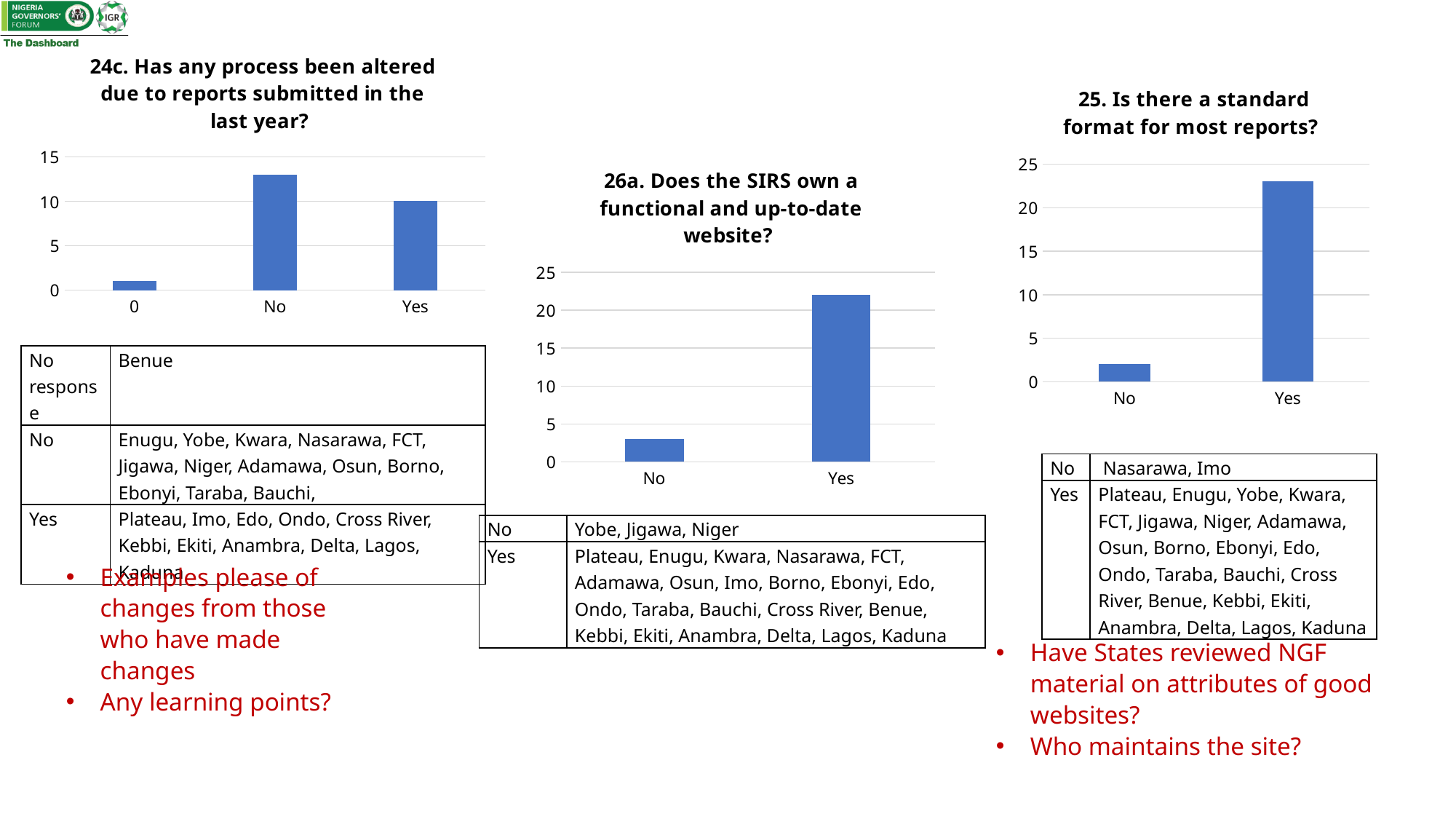
In the chart "24c. Has any process been altered due to reports submitted in the last year?", how many categories are shown on the x axis? 3 In the chart "26a. Does the SIRS own a functional and up-to-date website?", is the value for No greater or less than 5? less What type of chart is used for "24c. Has any process been altered due to reports submitted in the last year?"? bar chart What is the highest value shown on the y axis of the chart "25. Is there a standard format for most reports?"? 25 In the chart "26a. Does the SIRS own a functional and up-to-date website?", is the value for Yes greater or less than 20? greater In the chart "24c. Has any process been altered due to reports submitted in the last year?", is the value for No greater or less than 10? greater In the chart "25. Is there a standard format for most reports?", how many categories are shown on the x axis? 2 In the chart "25. Is there a standard format for most reports?", which category has the lowest value? No In the chart "24c. Has any process been altered due to reports submitted in the last year?", which category has the highest value? No In the chart "24c. Has any process been altered due to reports submitted in the last year?", which category has the lowest value? 0 In the chart "26a. Does the SIRS own a functional and up-to-date website?", which category has the higher value, No or Yes? Yes